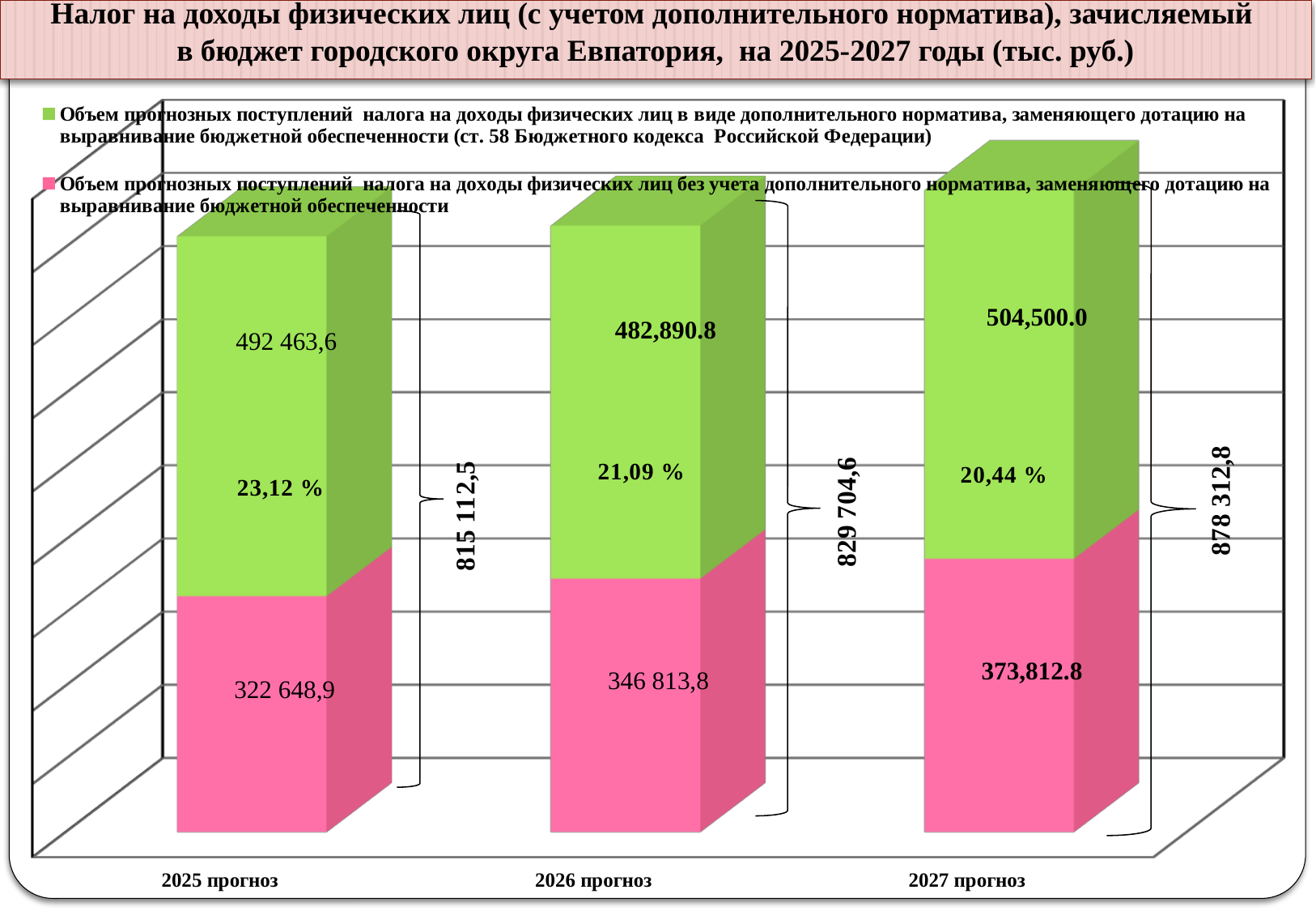
What is the total value shown for the 2027 прогноз bar? 878 312,8 What is the value of the pink segment for 2027 прогноз? 373,812.8 What percentage is printed on the 2025 прогноз bar? 23,12 % Which year has the highest total value? 2027 прогноз How many series does the chart legend list? 2 How many categories (years) are shown on the x axis of the chart? 3 Do the total values rise or fall from 2025 прогноз to 2027 прогноз? rise Which year has the lowest pink segment value (without the additional normative)? 2025 прогноз What is the value of the green segment (additional normative) for 2026 прогноз? 482,890.8 What type of chart is shown on the slide? bar chart What is the total value shown for the 2026 прогноз bar? 829 704,6 What is the value of the pink segment (without the additional normative) for 2025 прогноз? 322 648,9